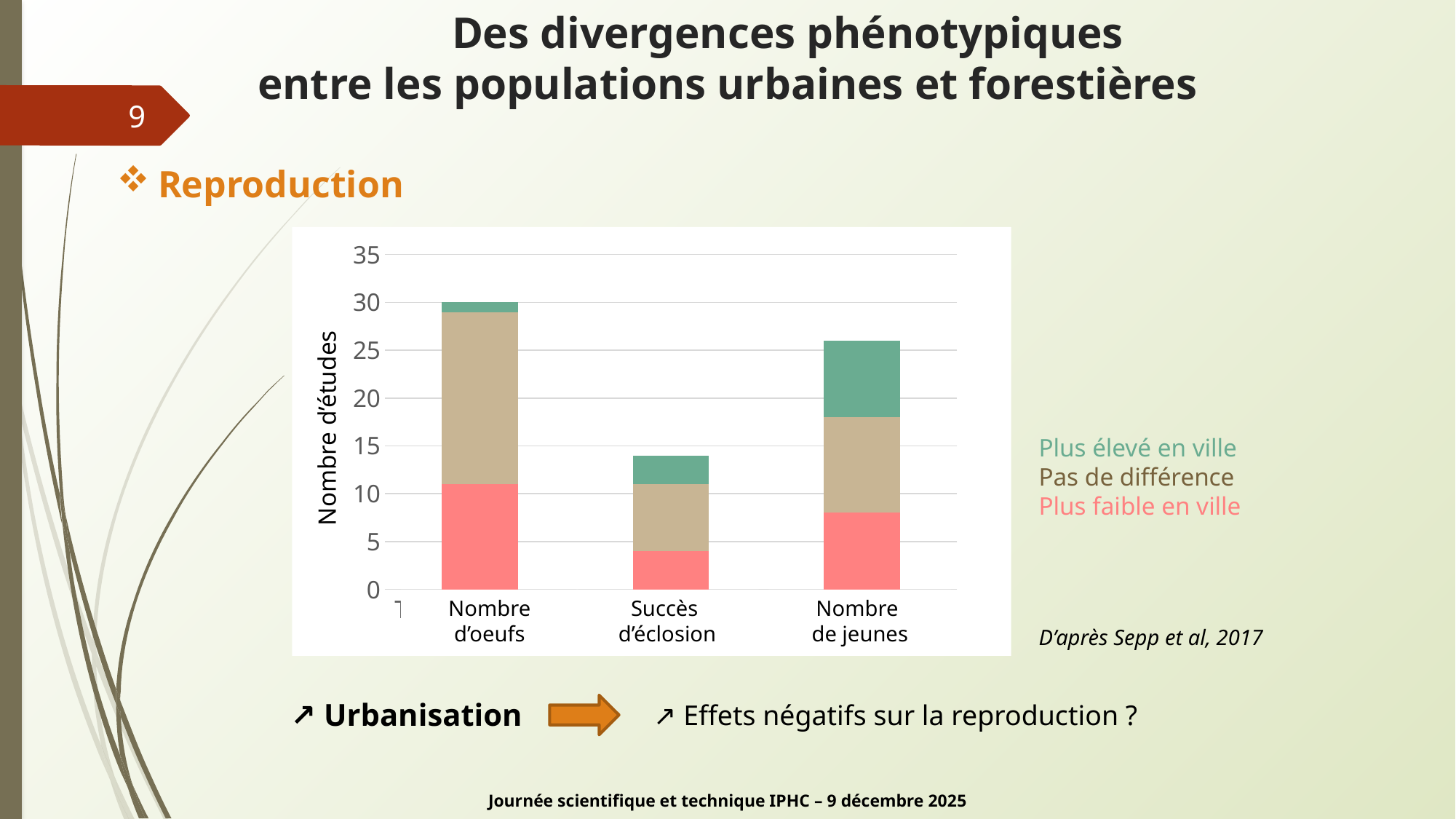
Which colour represents 'Plus élevé en ville' in the chart? green Is the total for Nombre de jeunes greater or less than 25? greater How many series does the chart's legend list? 3 Is the total for Succès d'éclosion greater or less than 15? less How many categories are shown on the x axis of the chart? 3 Which category has the shortest stacked bar? Succès d'éclosion What is the total number of studies for the Nombre d'oeufs bar? 30 Is the 'Plus faible en ville' value for Nombre d'oeufs greater or less than 10? greater Which category has the larger 'Plus faible en ville' segment, Nombre d'oeufs or Nombre de jeunes? Nombre d'oeufs Which category has the tallest stacked bar? Nombre d'oeufs What kind of chart is shown on the slide? bar chart What is the label of the y axis of the chart? Nombre d'études